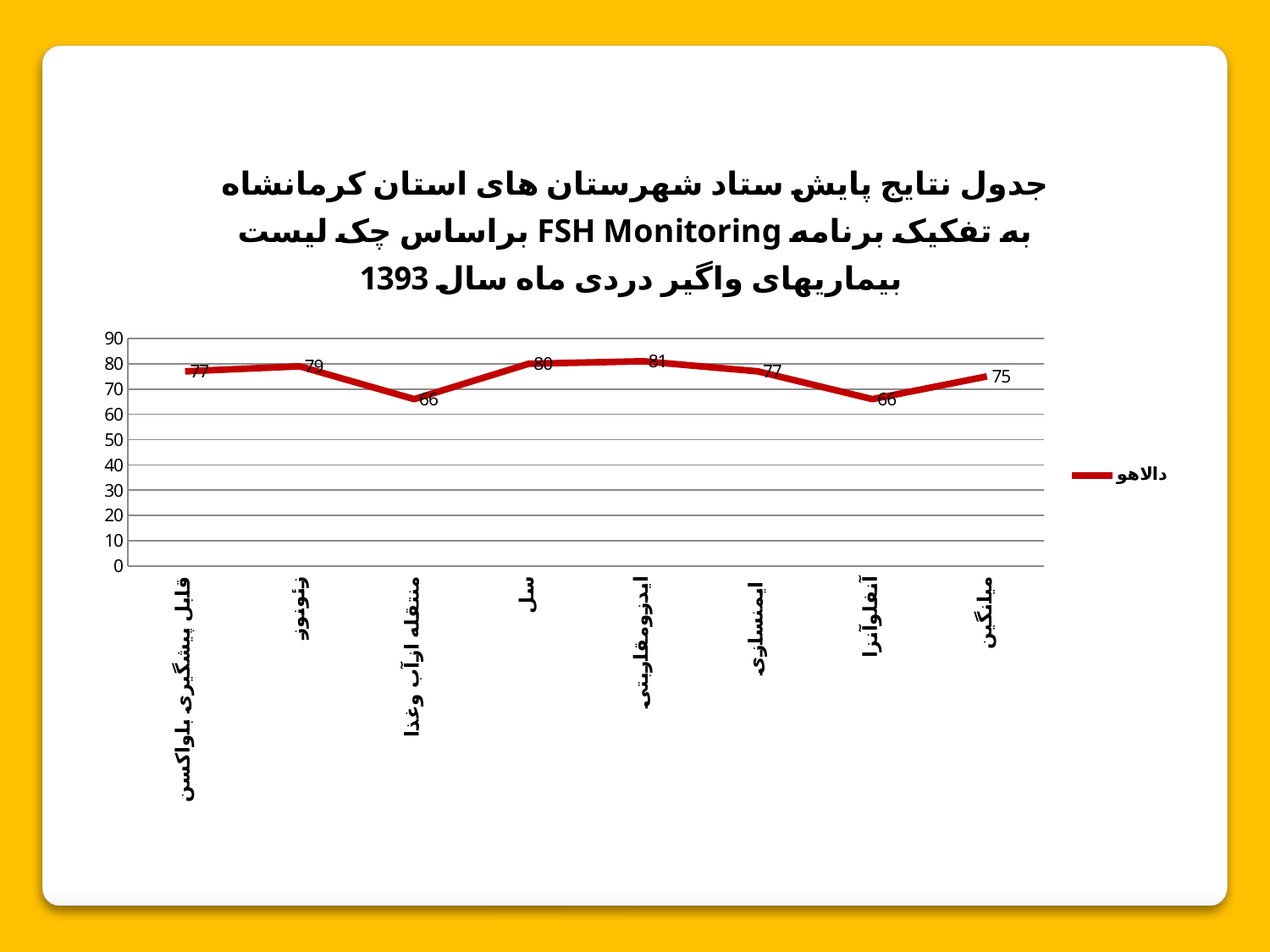
What is the value for ایمنسازی? 77 What is the name of the series shown in the legend? دالاهو What is the value for سل? 80 Which is larger, the value for زئونوز or the value for منتقله از آب و غذا? زئونوز What type of chart is shown on the slide? line chart Which category has the highest value? ایدز و مقاربتی Is the value for آنفلوآنزا greater or less than 70? less What is the value for زئونوز? 79 What is the difference between the values for ایدز و مقاربتی and آنفلوآنزا? 15 How many series does the legend list? 1 What is the value for میانگین? 75 How many categories are plotted on the x axis? 8